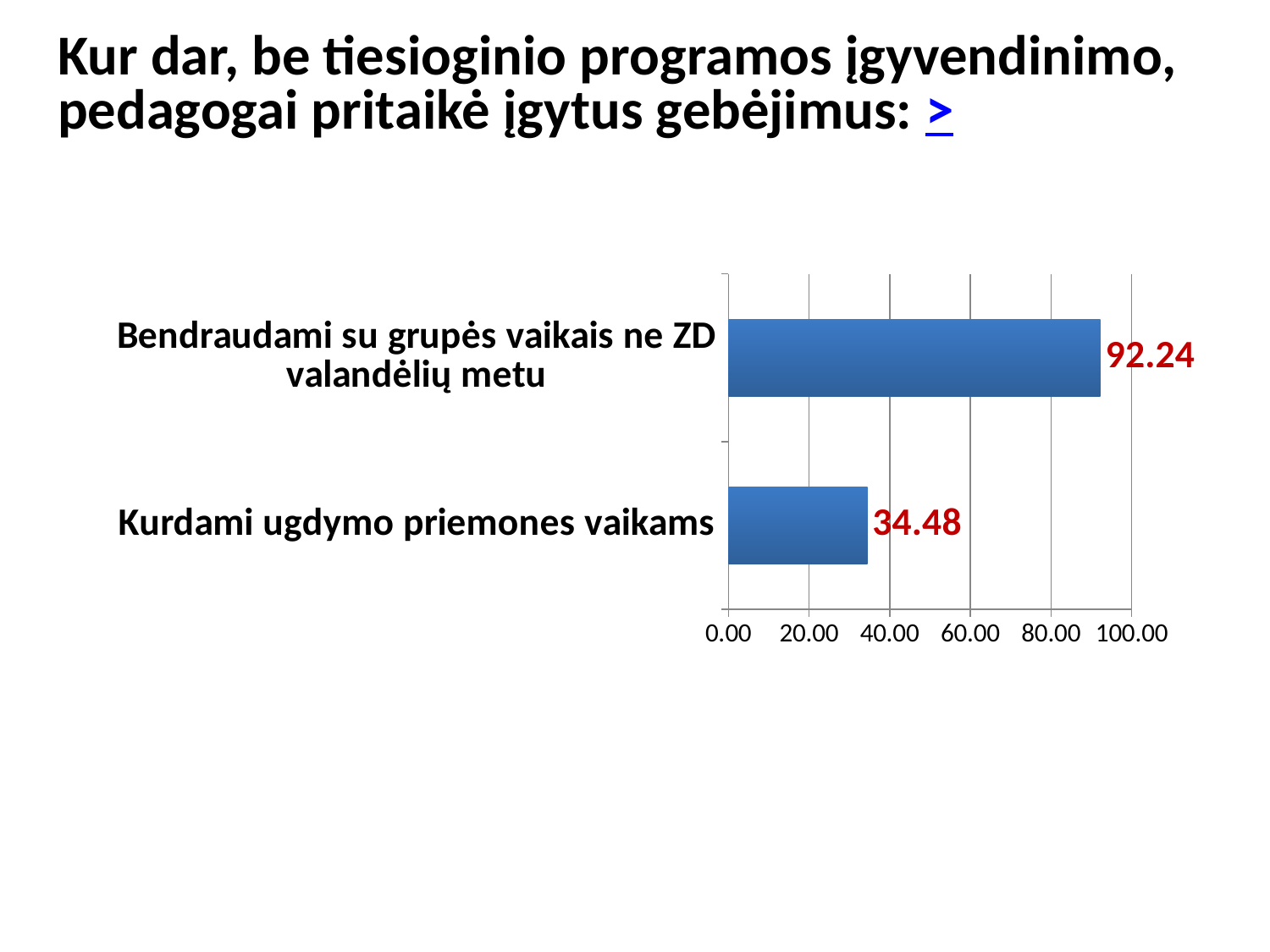
What colour are the bars in the chart? blue Which category has the highest value? Bendraudami su grupės vaikais ne ZD valandėlių metu What is the maximum value shown on the horizontal axis? 100.00 Which is larger: the value for "Kurdami ugdymo priemones vaikams" or for "Bendraudami su grupės vaikais ne ZD valandėlių metu"? Bendraudami su grupės vaikais ne ZD valandėlių metu What kind of chart is shown on the slide? bar chart What is the value for "Kurdami ugdymo priemones vaikams"? 34.48 Which category has the lowest value? Kurdami ugdymo priemones vaikams What is the value for "Bendraudami su grupės vaikais ne ZD valandėlių metu"? 92.24 How many categories are shown in the chart? 2 Is the value for "Bendraudami su grupės vaikais ne ZD valandėlių metu" greater or less than 80.00? greater Is the value for "Kurdami ugdymo priemones vaikams" greater or less than 40.00? less What is the difference between the values for "Bendraudami su grupės vaikais ne ZD valandėlių metu" and "Kurdami ugdymo priemones vaikams"? 57.76